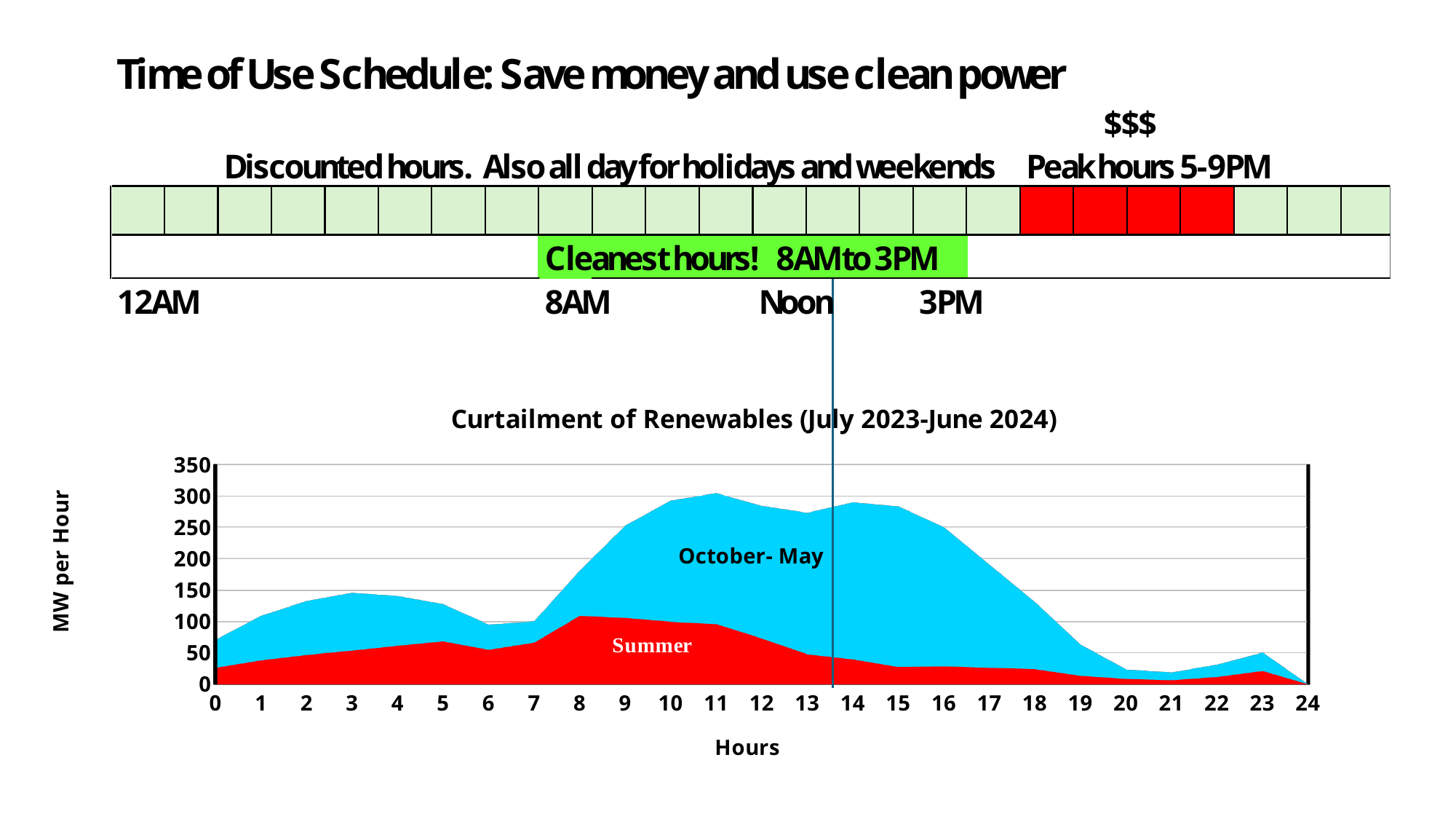
What is the title of the chart on the slide? Curtailment of Renewables (July 2023-June 2024) In the Curtailment of Renewables chart, does the October-May series rise or fall between hour 15 and hour 20? Fall What is the label of the y axis in the Curtailment of Renewables chart? MW per Hour In the Curtailment of Renewables chart, is the October-May value larger at hour 11 or at hour 3? Hour 11 In the Curtailment of Renewables chart, is the Summer value at hour 20 greater or less than 50? less In the Curtailment of Renewables chart, is the Summer value larger at hour 8 or at hour 20? Hour 8 How many hour points are labelled on the x axis of the Curtailment of Renewables chart? 25 What kind of chart is the "Curtailment of Renewables (July 2023-June 2024)" chart? Area chart In the Curtailment of Renewables chart, is the Summer value at hour 0 greater or less than 50? less How many data series are plotted in the Curtailment of Renewables chart? 2